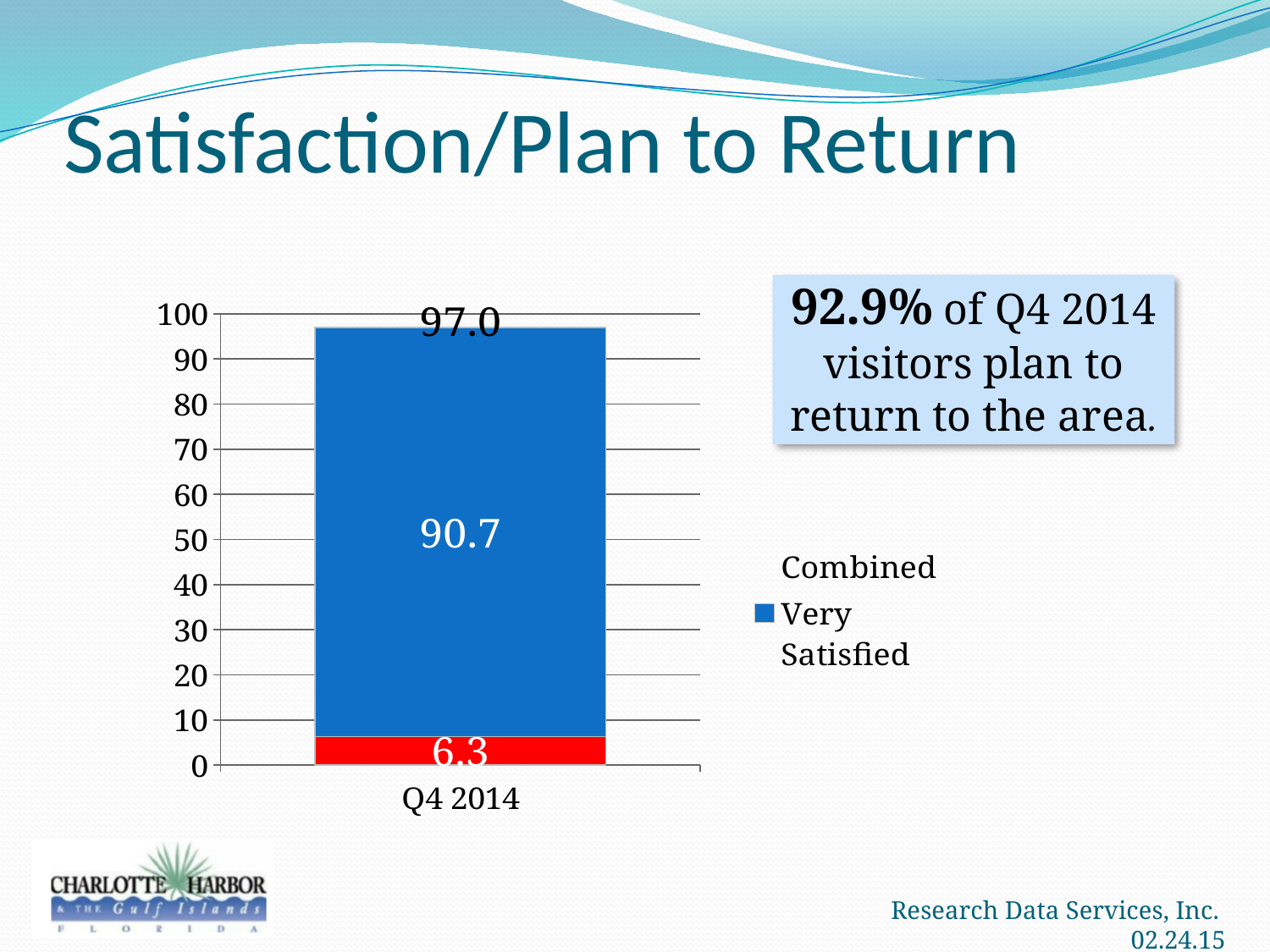
What is the difference between the Very Satisfied value (90.7) and the red segment value (6.3)? 84.4 What category label appears on the x axis of the chart? Q4 2014 Is the red segment value for Q4 2014 greater or less than 10? less What is the value of the Very Satisfied segment for Q4 2014? 90.7 How many categories are shown on the x axis of the chart? 1 What colour is the Very Satisfied segment in the chart? blue Which segment of the Q4 2014 bar is larger, the blue Very Satisfied segment or the red segment? Very Satisfied What type of chart is shown on the slide? bar chart What is the maximum value shown on the y axis of the chart? 100 Is the Very Satisfied value for Q4 2014 greater or less than 50? greater What is the combined total shown at the top of the Q4 2014 bar? 97.0 What is the value of the red segment at the bottom of the Q4 2014 bar? 6.3